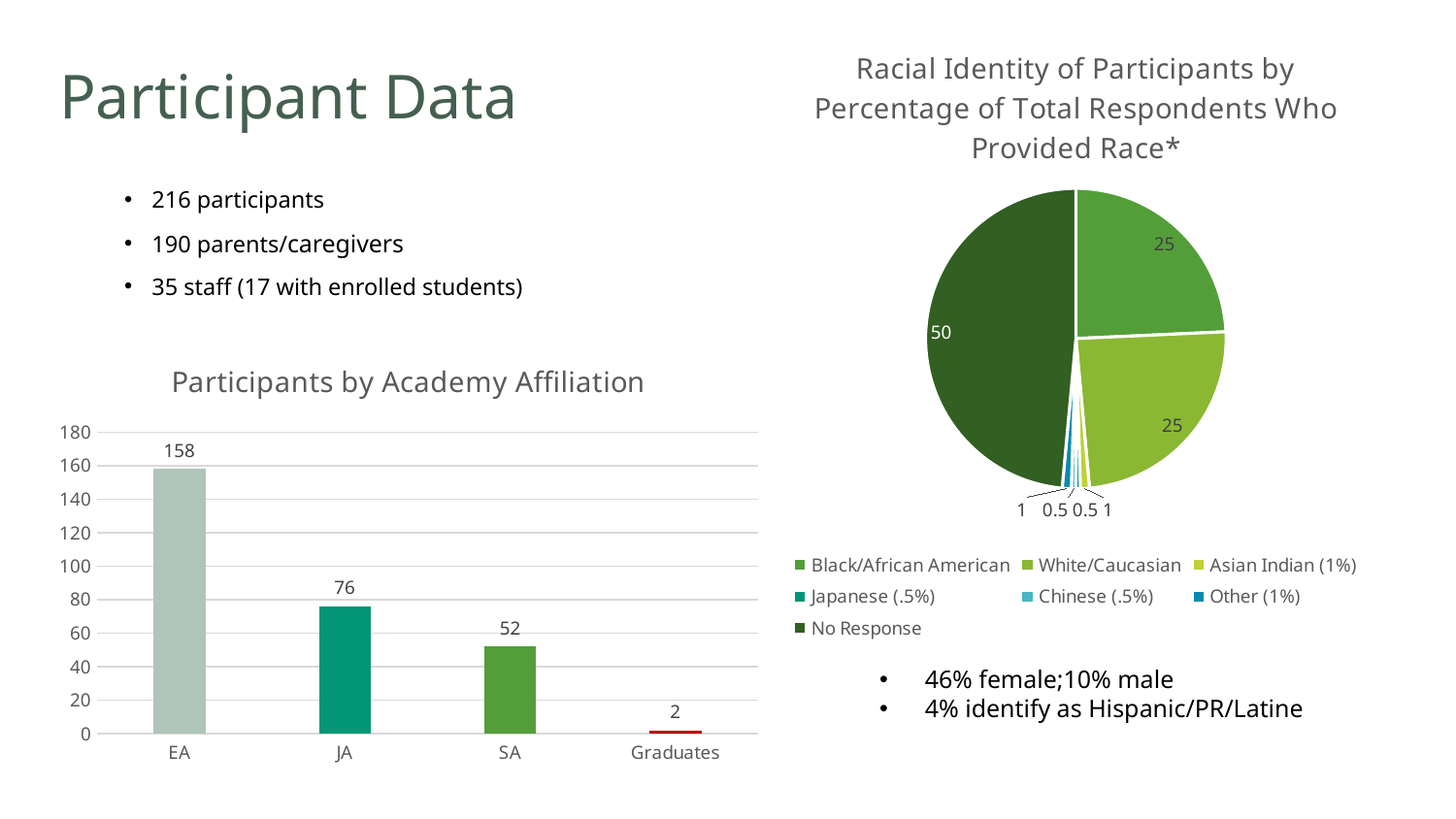
In the 'Participants by Academy Affiliation' chart, what is the value for Graduates? 2 How many entries does the legend of the 'Racial Identity of Participants' pie chart list? 7 In the 'Participants by Academy Affiliation' chart, which category has the lowest value? Graduates In the 'Participants by Academy Affiliation' chart, which is larger, the value for SA or the value for JA? JA What type of chart is 'Participants by Academy Affiliation'? Bar chart In the 'Racial Identity of Participants' pie chart, what value is shown for No Response? 50 In the 'Participants by Academy Affiliation' chart, what is the value for EA? 158 In the 'Participants by Academy Affiliation' chart, what is the difference between the values for JA and SA? 24 In the 'Racial Identity of Participants' pie chart, which category has the largest slice? No Response In the 'Participants by Academy Affiliation' chart, which category has the highest value? EA How many categories are shown in the 'Participants by Academy Affiliation' chart? 4 In the 'Participants by Academy Affiliation' chart, what is the value for JA? 76